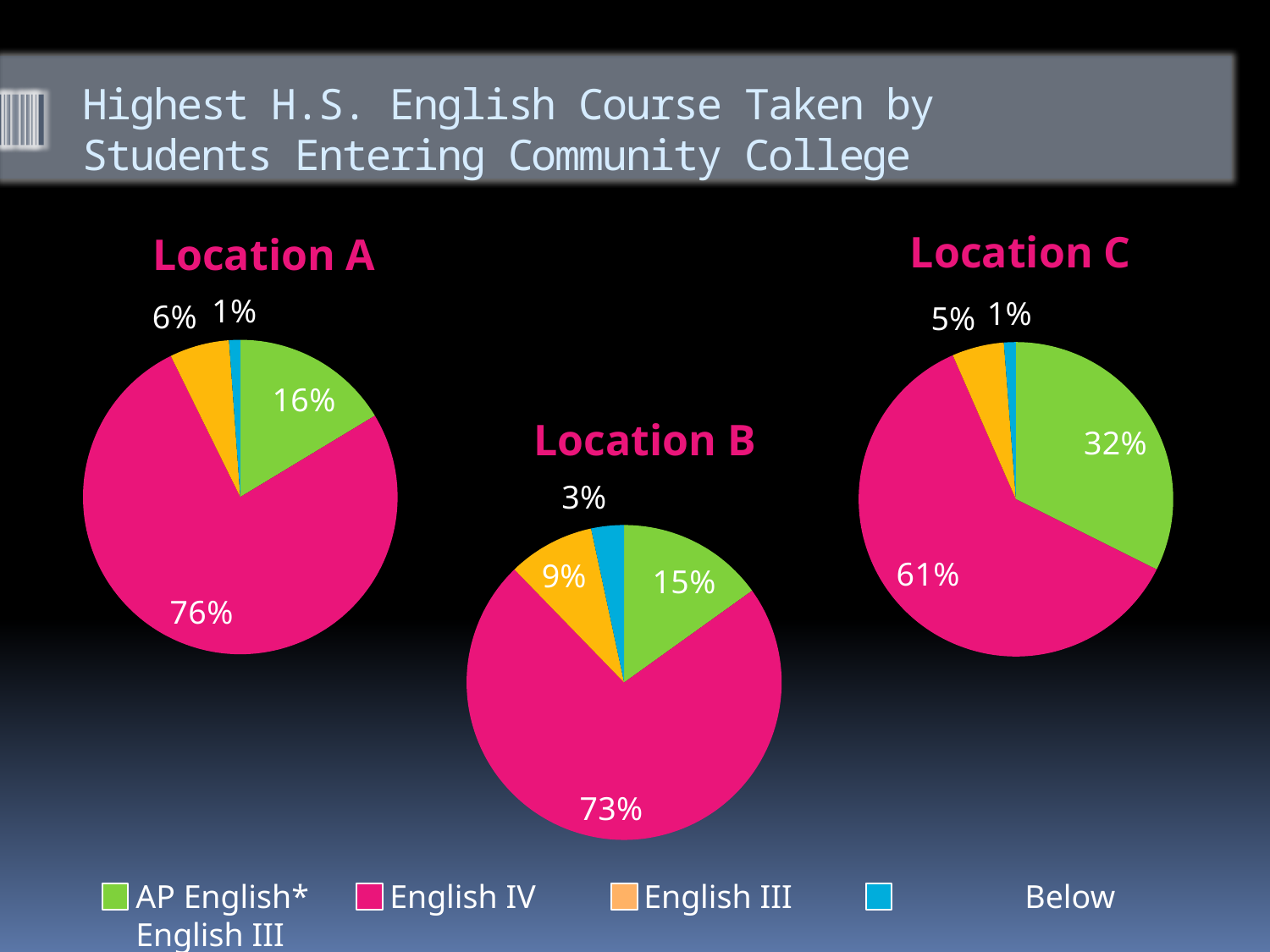
In the Location B pie chart, what percentage is shown for English III? 9% What type of chart is used for Location A? Pie chart In the Location A pie chart, what share of students had English IV as their highest course? 76% Which is larger: the AP English* share in Location A or the AP English* share in Location B? Location A What is the difference between the English IV share in Location A and the English IV share in Location C? 15% How many categories does the legend list? 4 In the Location B pie chart, what percentage is shown for Below English III? 3% In the Location C pie chart, which category has the largest slice? English IV In the Location A pie chart, which category has the smallest slice? Below English III Which colour represents English IV in the pie charts? Pink In the Location C pie chart, what percentage is shown for AP English*? 32% How many slices does the Location B pie chart have? 4